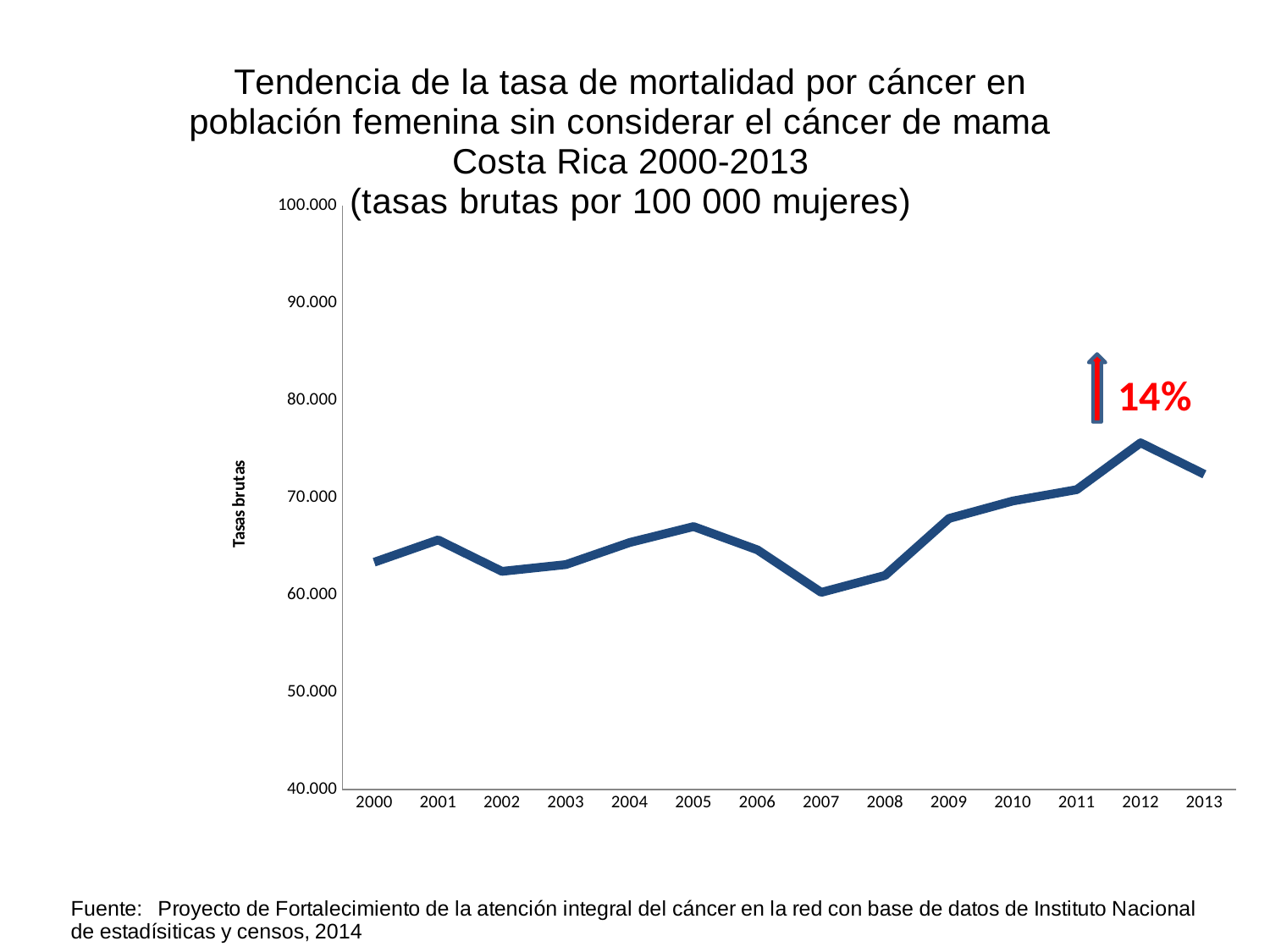
Is the value for 2000 greater or less than 60.000? greater Is the value for 2012 greater or less than 70.000? greater Does the line rise or fall between 2007 and 2012? rise Is the value for 2007 greater or less than 70.000? less Which year has the larger value, 2000 or 2012? 2012 What percentage is shown in red next to the arrow on the chart? 14% How many years are plotted along the x axis of the chart? 14 Which year has the larger value, 2007 or 2010? 2010 In which year does the line reach its lowest value? 2007 In which year does the line reach its highest value? 2012 What kind of chart is shown on the slide? line chart